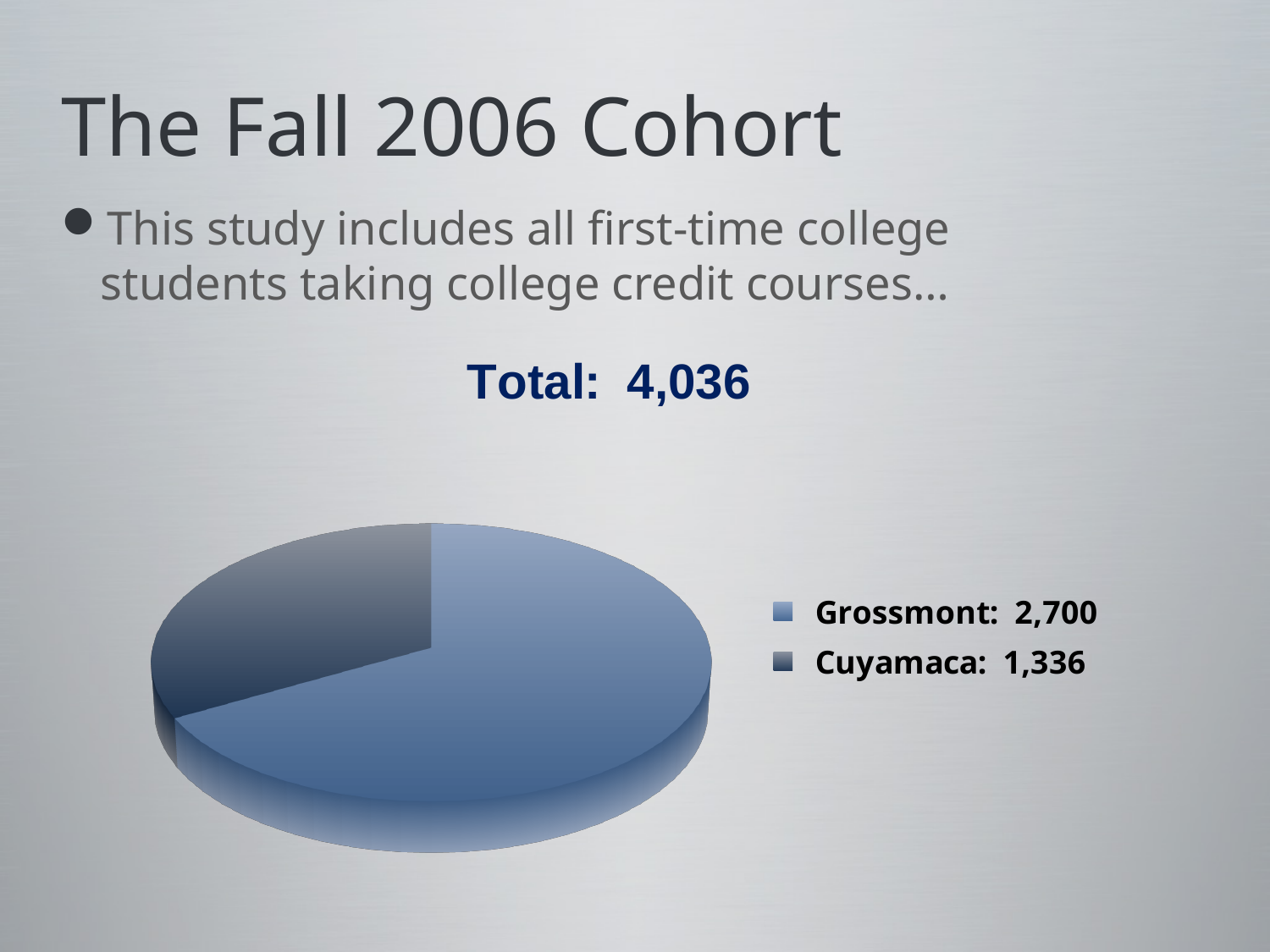
What is the title of the slide containing the pie chart? The Fall 2006 Cohort How many entries does the legend of the pie chart list? 2 Which is larger, the value for Grossmont or the value for Cuyamaca? Grossmont Which college has the larger slice of the pie chart? Grossmont What is the total shown above the pie chart? 4,036 What is the value for Grossmont in the pie chart? 2,700 What kind of chart is shown on the slide? pie chart What is the difference between the Grossmont value and the Cuyamaca value? 1,364 How many slices does the pie chart have? 2 Which college has the smaller slice of the pie chart? Cuyamaca What share of the total does Grossmont represent, to one decimal place? 66.9% What is the value for Cuyamaca in the pie chart? 1,336